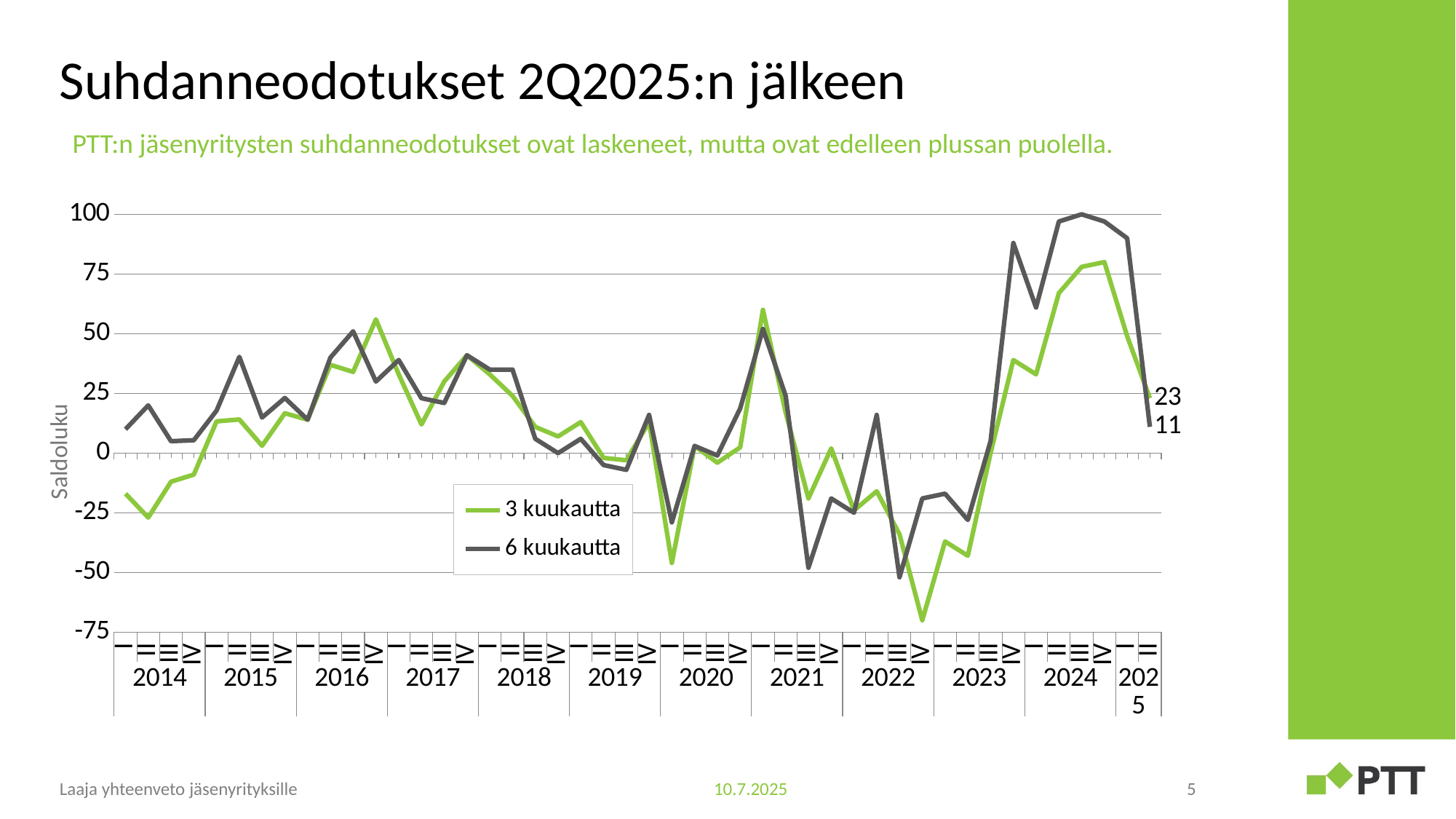
What is the latest (2025) value labelled for the 3 kuukautta series? 23 How many series does the legend list? 2 What is the difference between the latest labelled values of the 3 kuukautta and 6 kuukautta series? 12 Is the lowest value of the 3 kuukautta series in 2022 greater or less than -50? less What is the latest (2025) value labelled for the 6 kuukautta series? 11 Is the peak value of the 6 kuukautta series in 2024 greater or less than 75? greater What is the title of the vertical axis? Saldoluku How many years are labelled on the x axis? 12 What kind of chart is shown on the slide? line chart Which series reaches the highest value anywhere on the chart? 6 kuukautta Do the values of both series rise or fall from their 2024 peaks to the last point in 2025? fall At the last data point, which series has the higher value, 3 kuukautta or 6 kuukautta? 3 kuukautta